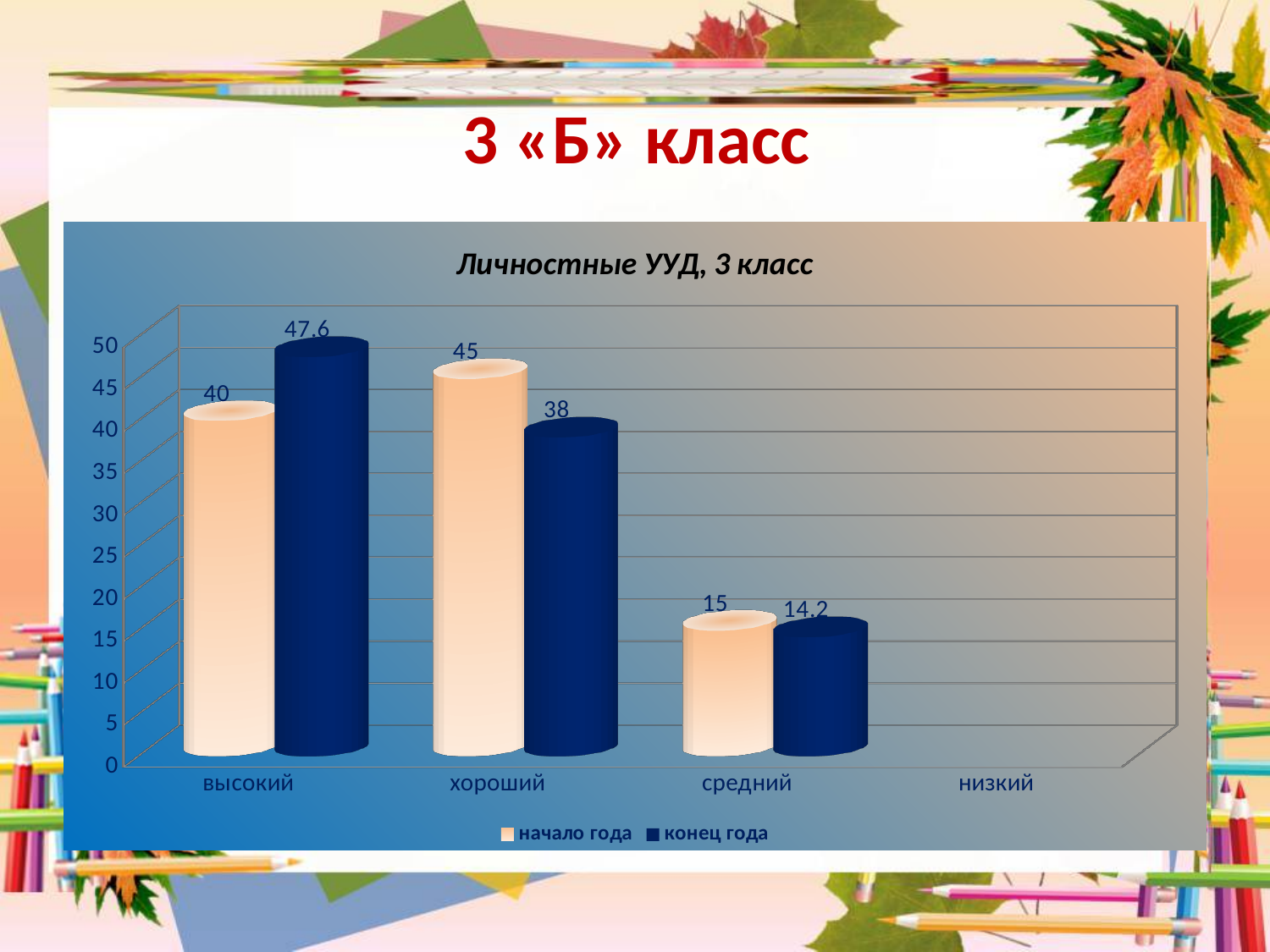
What is the value for "средний" in the "начало года" series? 15 What is the value for "высокий" in the "конец года" series? 47.6 What is the title of the chart? Личностные УУД, 3 класс What is the value for "высокий" in the "начало года" series? 40 What kind of chart is shown on the slide? bar chart What is the difference between the "конец года" and "начало года" values for "высокий"? 7.6 How many series does the legend list? 2 Which category has the highest value in the "конец года" series? высокий What is the difference between the "начало года" and "конец года" values for "хороший"? 7 Which category has the highest value in the "начало года" series? хороший What is the value for "хороший" in the "конец года" series? 38 For "средний", which is larger: the "начало года" value or the "конец года" value? начало года